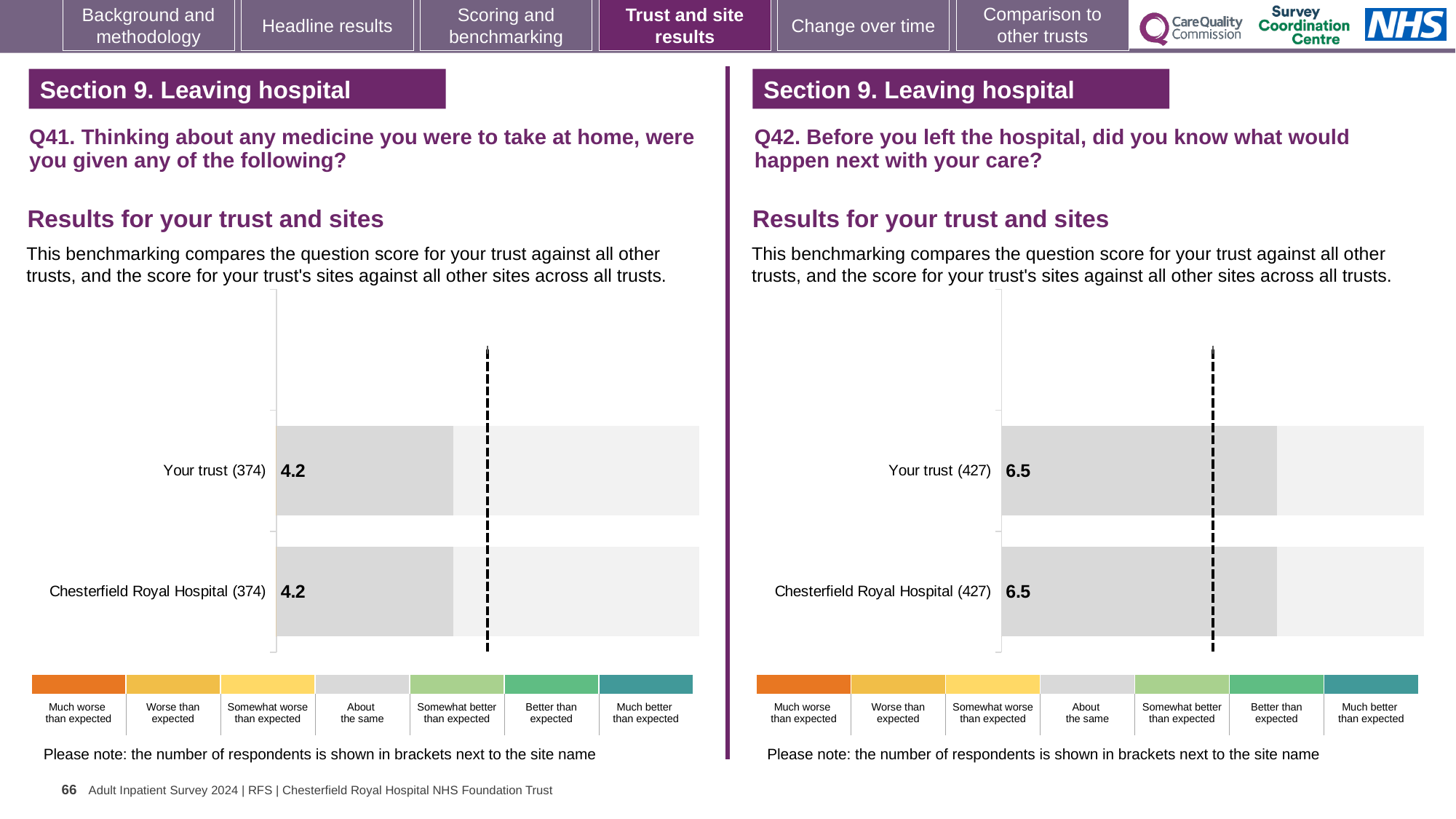
In the Q41 chart on the left, how many respondents are shown in brackets next to Your trust? 374 In the Q41 chart on the left, what is the score for Chesterfield Royal Hospital? 4.2 Which is larger: the Your trust score in the Q42 chart on the right or the Your trust score in the Q41 chart on the left? Q42 chart (6.5) How many bars are plotted in the Q41 chart on the left? 2 In the Q42 chart on the right, what is the score for Your trust? 6.5 What kind of chart is used for the Q41 results on the left? Bar chart In the Q42 chart on the right, what is the score for Chesterfield Royal Hospital? 6.5 In the Q41 chart on the left, what is the score for Your trust? 4.2 How many bars are plotted in the Q42 chart on the right? 2 In the Q42 chart on the right, how many respondents are shown in brackets next to Chesterfield Royal Hospital? 427 What is the difference between the Your trust score in the Q42 chart on the right and the Your trust score in the Q41 chart on the left? 2.3